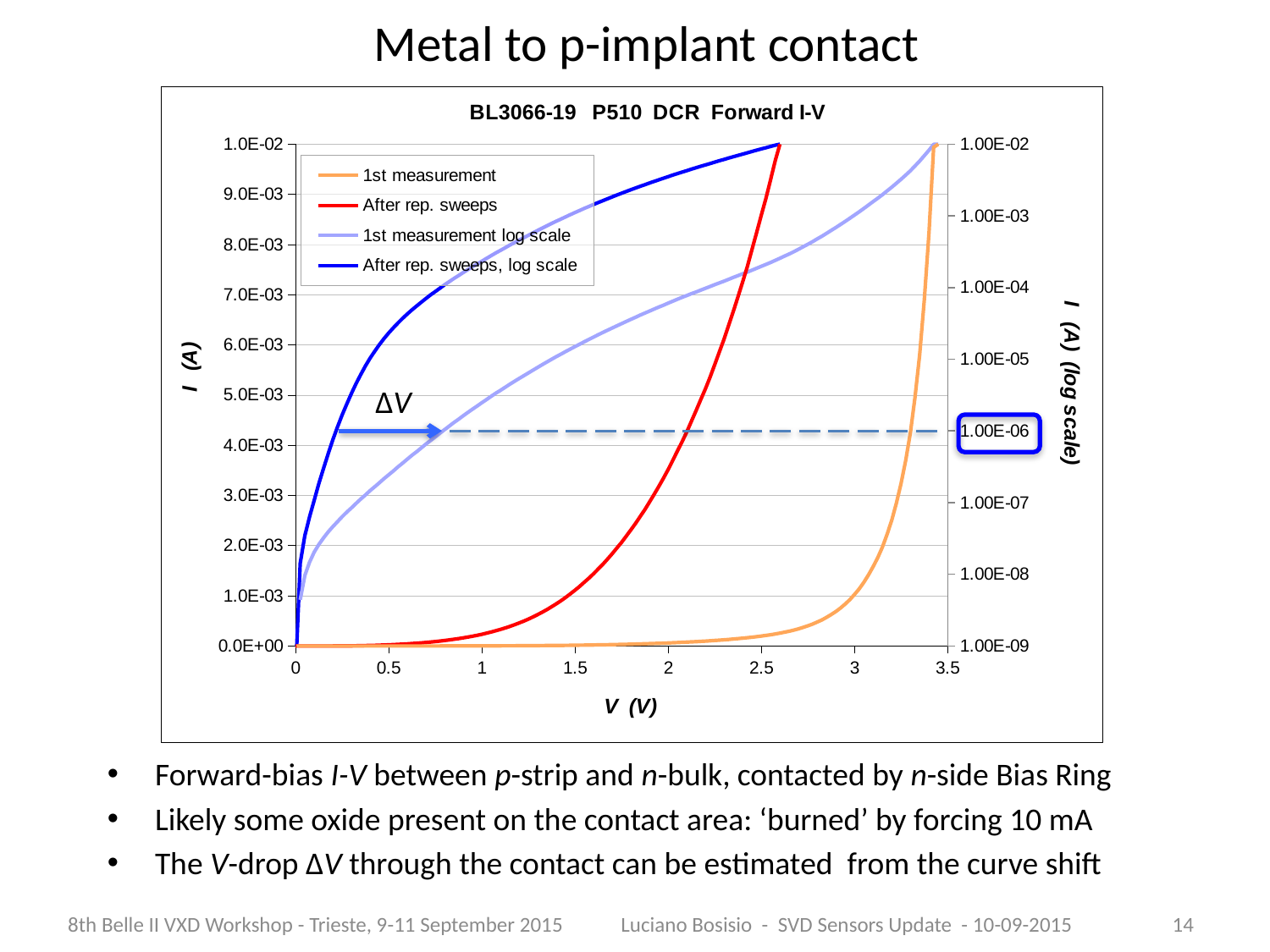
What is the maximum voltage shown on the x axis of the chart? 3.5 What is the highest value shown on the left y axis of the chart? 1.0E-02 Do the current values rise or fall as the voltage increases along the x axis? Rise Is the current of the '1st measurement' series at V = 3 greater or less than 1.0E-03 on the linear scale? less Is the current of the 'After rep. sweeps' series at V = 2 greater or less than 2.0E-03 on the linear scale? greater What kind of chart is shown on the slide? Line chart What is the lowest value shown on the right (log scale) y axis of the chart? 1.00E-09 At V = 2.5, which series has the larger current on the linear scale: '1st measurement' or 'After rep. sweeps'? After rep. sweeps Which series reaches 1.0E-02 A at the lower voltage: '1st measurement' or 'After rep. sweeps'? After rep. sweeps How many series does the chart legend list? 4